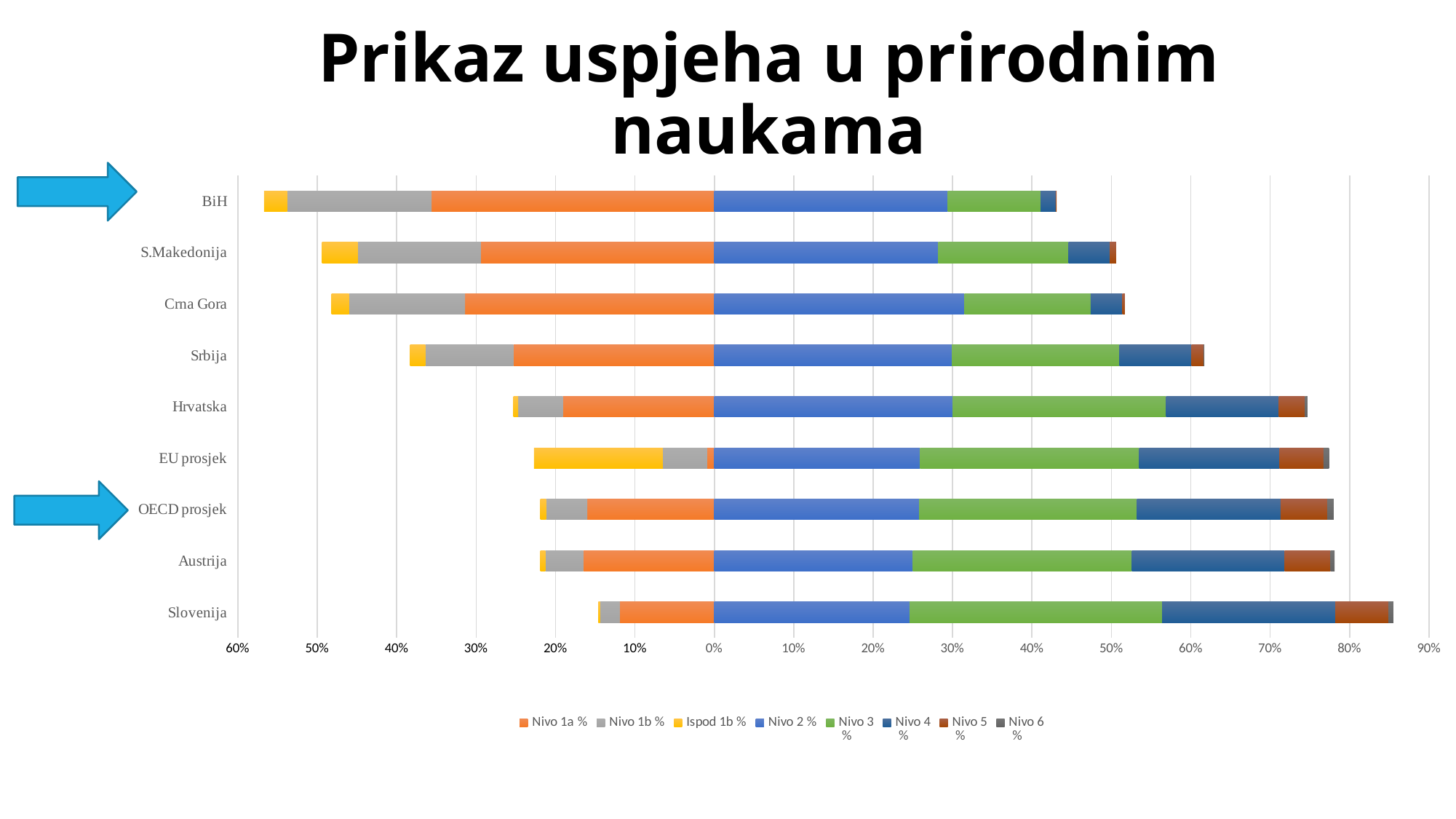
How many categories (countries/averages) are plotted on the chart? 9 What kind of chart is shown on the slide? bar chart How many series does the legend list? 8 Is the right-hand end of the Slovenija bar greater or less than 80%? greater Is the left-hand end of the Slovenija bar greater or less than 20%? less Is the left-hand end of the BiH bar greater or less than 50%? greater What is the title of the chart on the slide? Prikaz uspjeha u prirodnim naukama Which colour represents the series 'Nivo 3 %' in the legend? green Which bar extends further to the right of the 0% axis, Slovenija or BiH? Slovenija Which category's bar extends furthest to the left (negative side) of the axis? BiH Which category's bar extends furthest to the right (positive side) of the axis? Slovenija